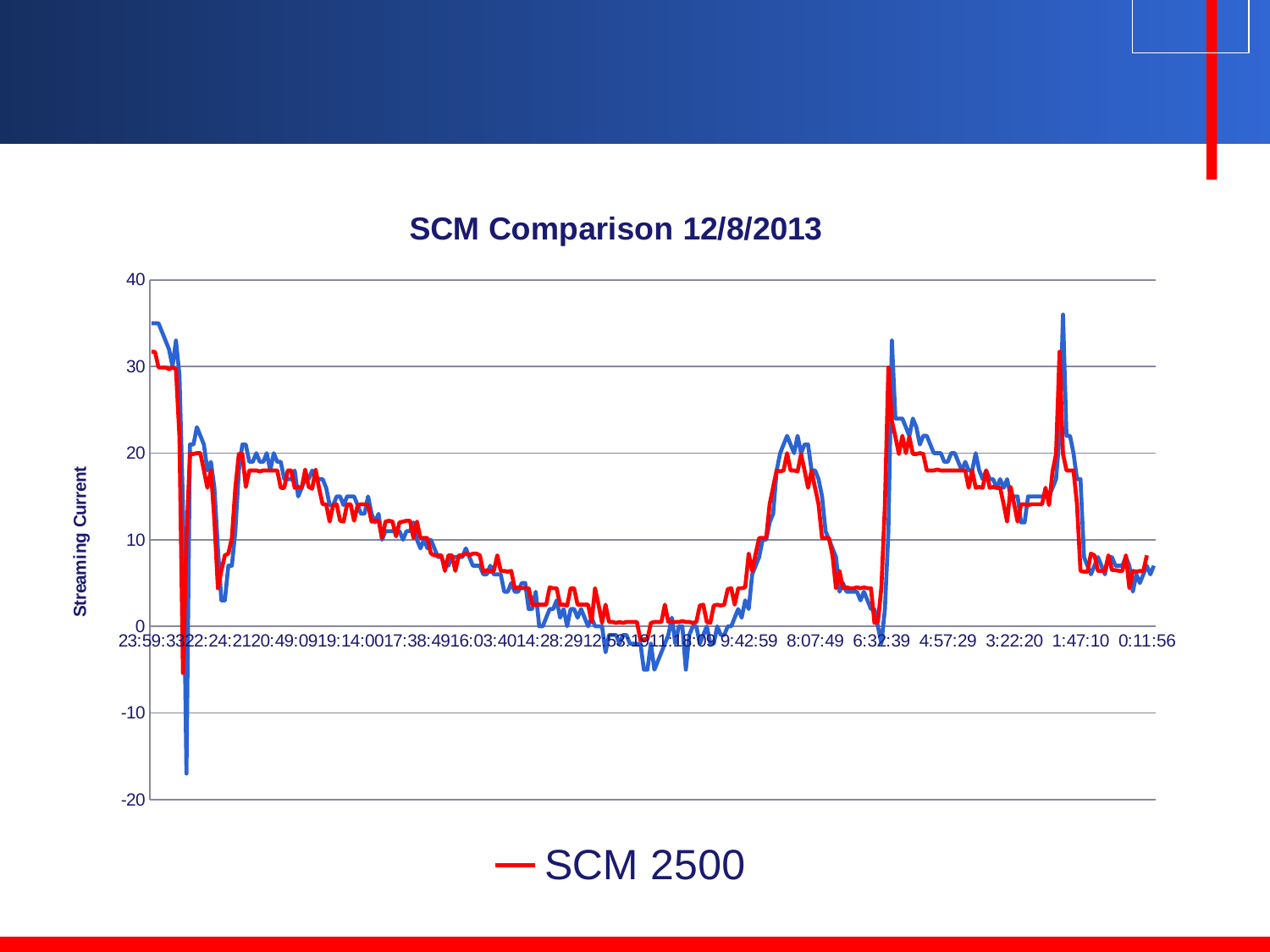
Does the SCM 2500 line generally rise or fall between 20:49:09 and 12:53:19? fall What type of chart is shown on the slide? line chart What is the highest value shown on the vertical axis? 40 Is the SCM 2500 value at 0:11:56 greater or less than 10? less Is the SCM 2500 value at 4:57:29 greater or less than 10? greater Which is larger for SCM 2500: the value at 8:07:49 or the value at 0:11:56? 8:07:49 Is the SCM 2500 value at 11:18:09 greater or less than 10? less Does the SCM 2500 line rise or fall between 9:42:59 and 8:07:49? rise What is the label on the vertical axis of the chart? Streaming Current How many series does the chart's legend list? 1 What is the title of the chart? SCM Comparison 12/8/2013 What is the lowest value shown on the vertical axis? -20